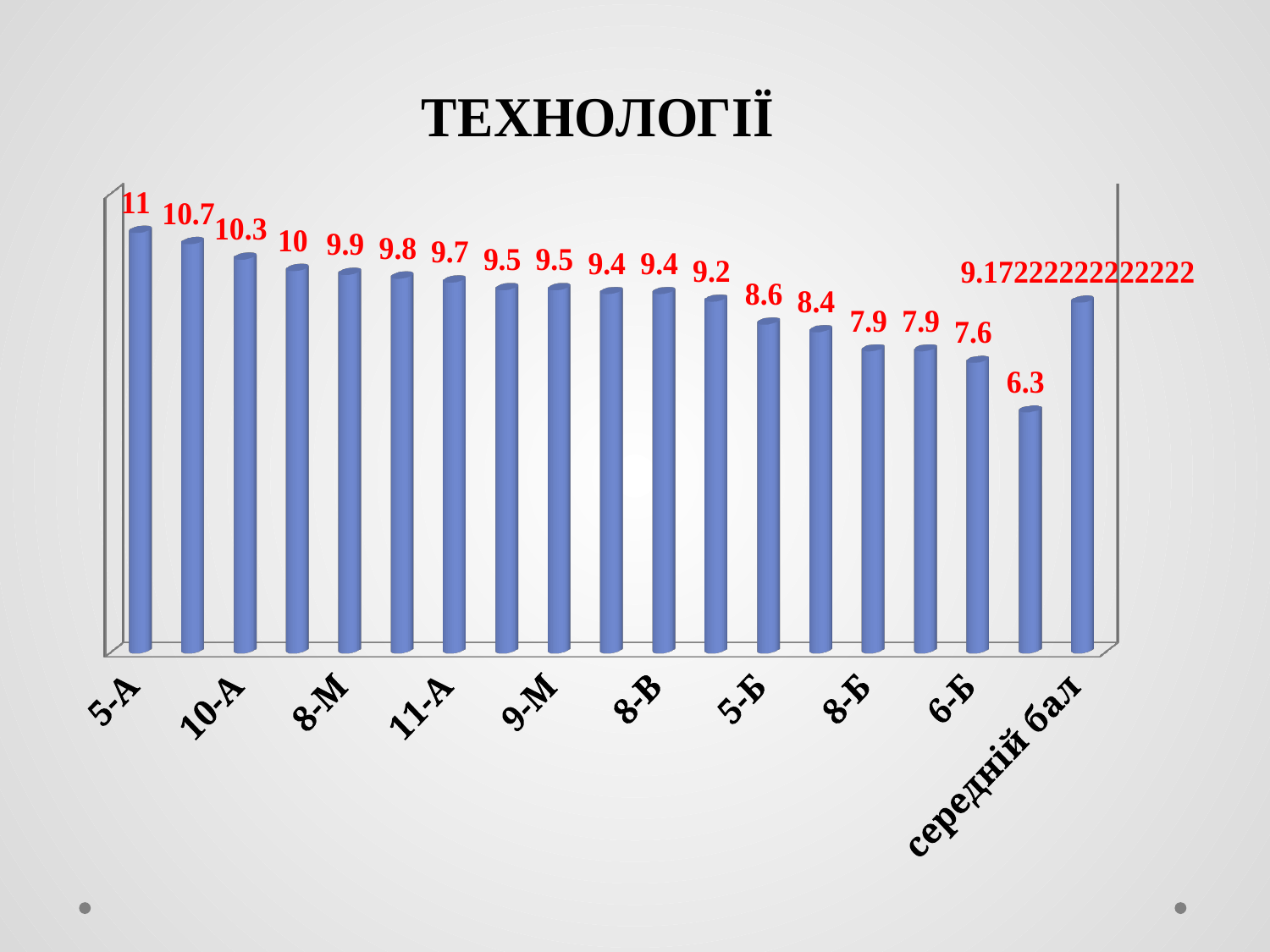
What is the title of the chart? ТЕХНОЛОГІЇ Which is larger, the value for 10-А or the value for 8-Б? 10-А What is the value for 8-М? 9.9 What is the difference between the values for 5-А and 6-Б? 3.4 What is the value for 11-А? 9.7 What is the value for 10-А? 10.3 Which category has the highest value? 5-А What kind of chart is shown on the slide? bar chart What is the value for 5-А? 11 What is the lowest value shown on the chart? 6.3 What is the value for 6-Б? 7.6 What is the value for середній бал? 9.17222222222222